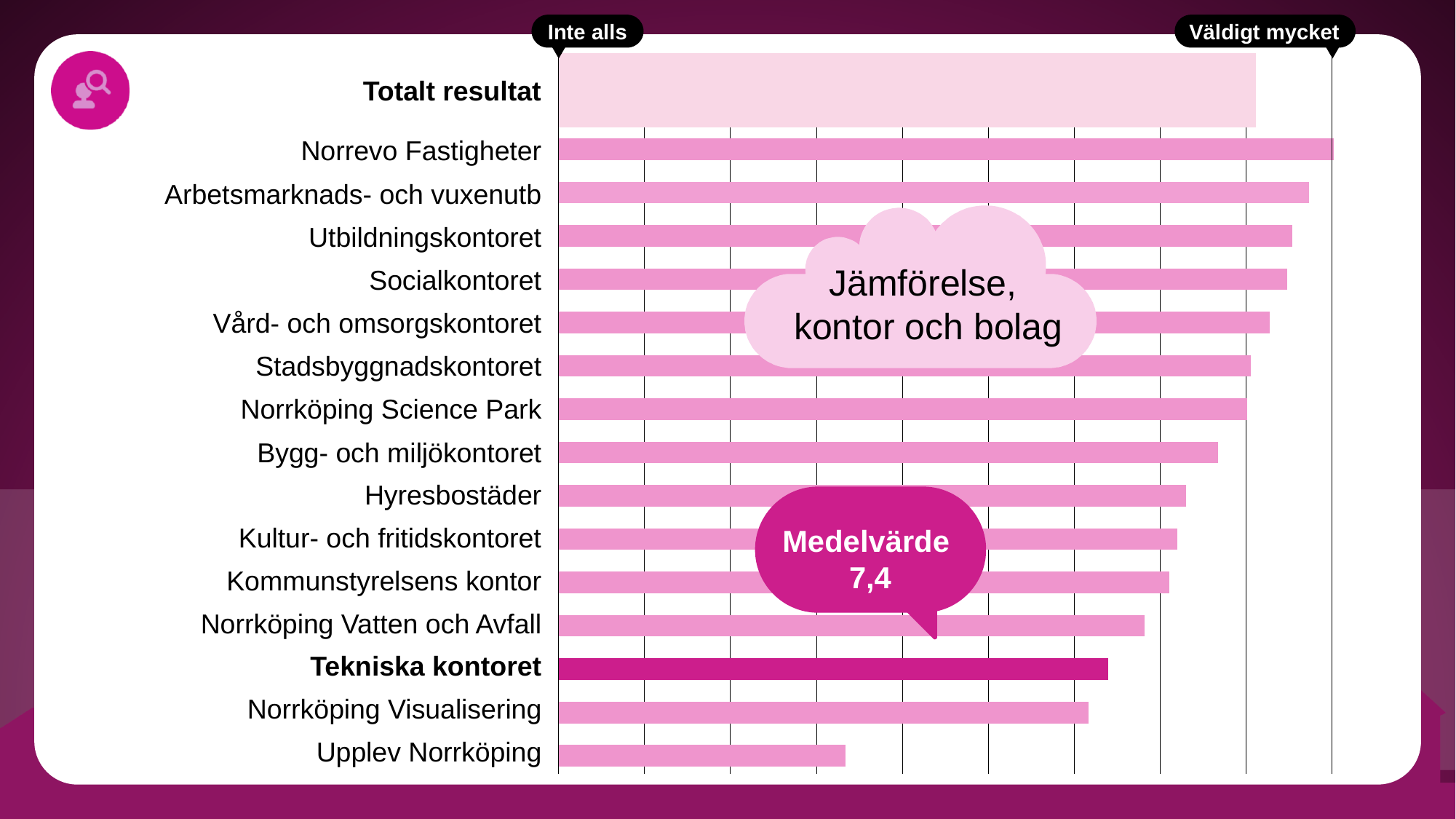
Which organisation has the lowest value in the chart? Upplev Norrköping Which has the larger value, Tekniska kontoret or Norrköping Visualisering? Tekniska kontoret Which organisation's bar is highlighted in a darker colour than the others? Tekniska kontoret Which organisation has the highest value in the chart (excluding Totalt resultat)? Norrevo Fastigheter What is the Medelvärde (mean value) shown in the speech bubble? 7,4 How many organisations are listed in the chart, not counting the Totalt resultat row? 15 Do the bar values rise or fall going from the top organisation to the bottom one? Fall What kind of chart is shown on the slide? Bar chart What are the labels at the left and right ends of the value axis? Inte alls and Väldigt mycket Which has the larger value, Bygg- och miljökontoret or Upplev Norrköping? Bygg- och miljökontoret Which has the larger value, Norrevo Fastigheter or Kommunstyrelsens kontor? Norrevo Fastigheter